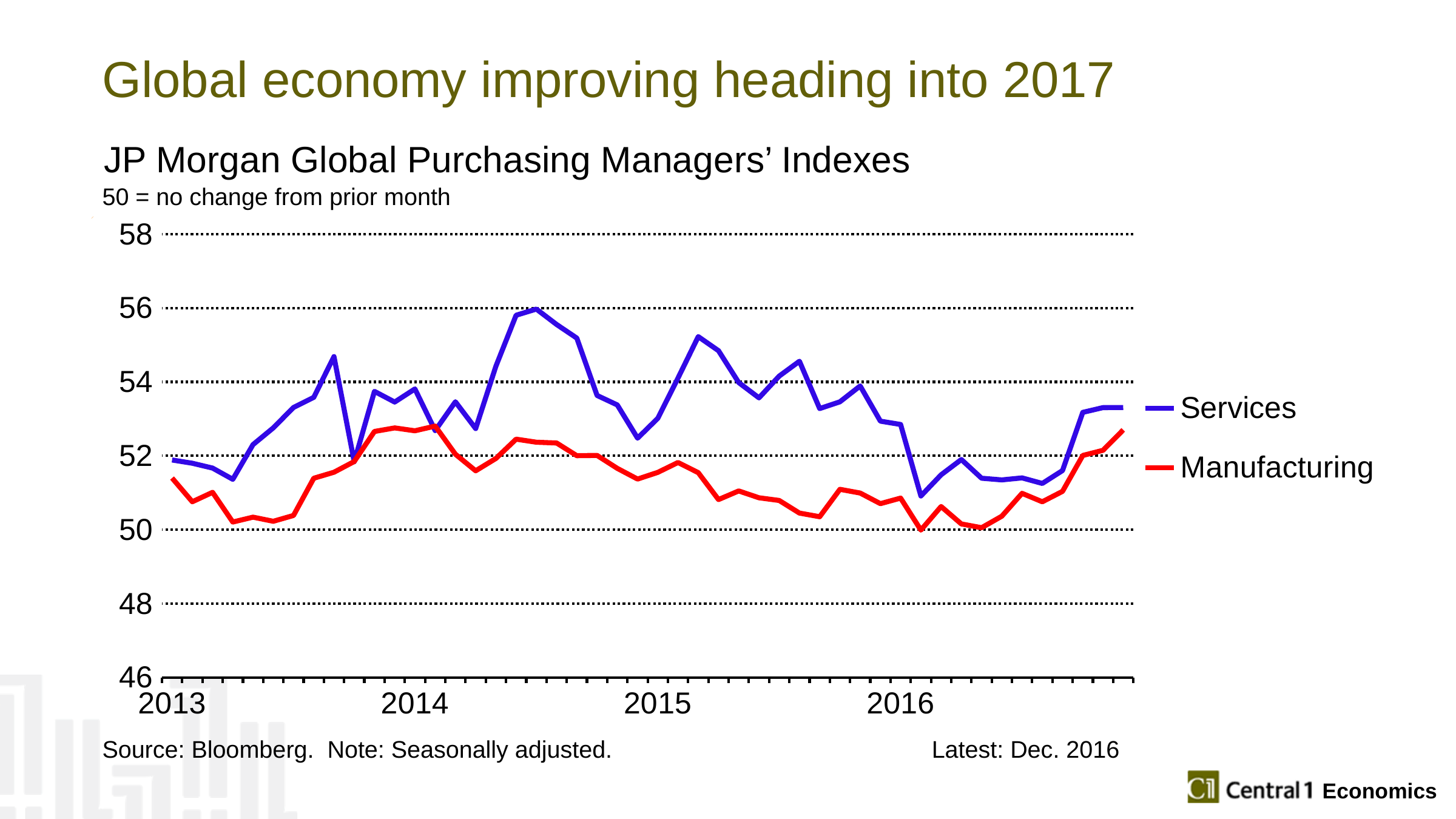
What colour is the Services line? Blue Is the Manufacturing value at the start of 2013 greater or less than 52? less What is the title of the chart? JP Morgan Global Purchasing Managers' Indexes Which series reaches the higher peak over the whole period, Services or Manufacturing? Services Is the highest value of the Manufacturing line greater or less than 54? less How many series does the legend list? 2 Is the Services value at the end of 2016 (the last point) greater or less than 52? greater Does the Manufacturing line rise or fall from early 2014 to early 2016? Fall What kind of chart is shown on the slide? Line chart At the last point on the chart (Dec. 2016), which series is higher, Services or Manufacturing? Services